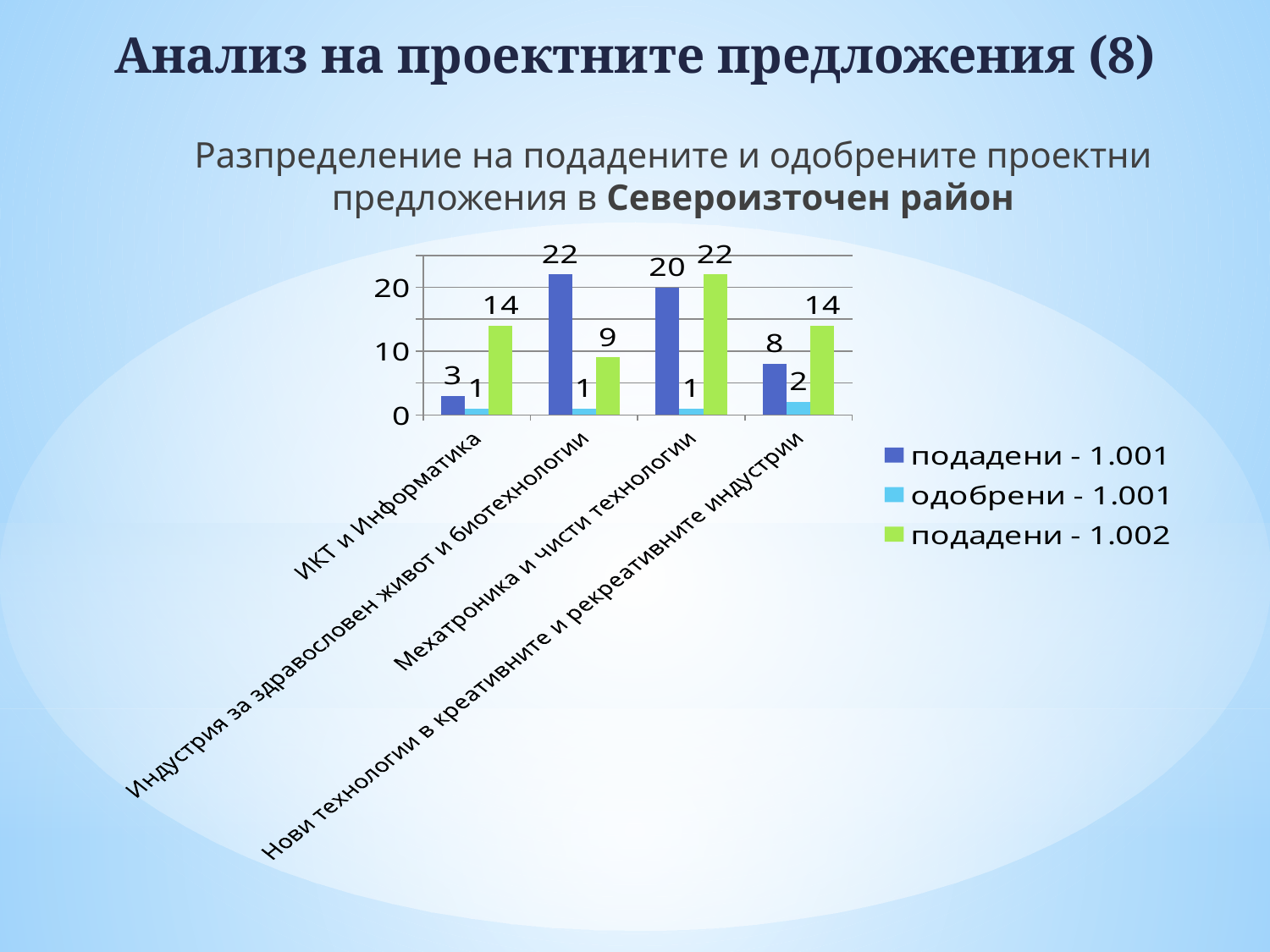
What type of chart is shown on the slide? bar chart For "Нови технологии в креативните и рекреативните индустрии", which is larger: "подадени - 1.001" or "подадени - 1.002"? подадени - 1.002 How many series does the legend list? 3 What is the difference between "подадени - 1.001" and "подадени - 1.002" for "Индустрия за здравословен живот и биотехнологии"? 13 Which category has the highest value for "подадени - 1.001"? Индустрия за здравословен живот и биотехнологии What is the value of "подадени - 1.002" for "Мехатроника и чисти технологии"? 22 Which colour represents the series "подадени - 1.002" in the chart? green Is the value of "подадени - 1.001" for "Мехатроника и чисти технологии" greater or less than 10? greater What is the value of "подадени - 1.001" for "ИКТ и Информатика"? 3 Which category has the lowest value for "подадени - 1.002"? Индустрия за здравословен живот и биотехнологии What is the value of "одобрени - 1.001" for "Нови технологии в креативните и рекреативните индустрии"? 2 How many categories are shown on the x axis? 4